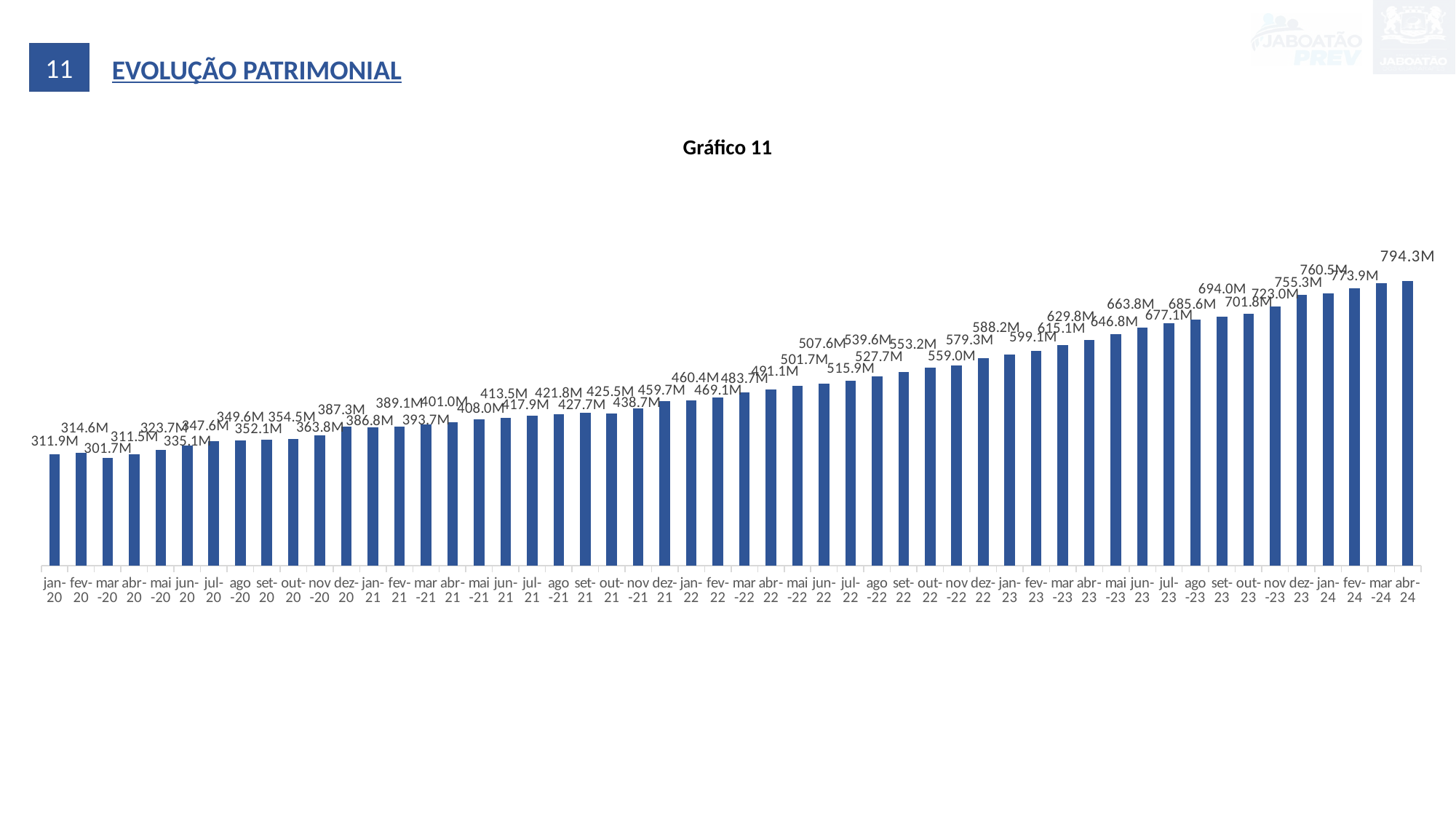
Which month has the highest value? abr-24 What is the value for dez-21? 459.7M How many months (bars) are shown on the chart? 52 What is the value for jun-23? 663.8M Which is larger, the value for dez-23 or the value for dez-22? dez-23 What is the title of the chart on the slide? Gráfico 11 What kind of chart is Gráfico 11? bar chart Do the values generally rise or fall from jan-20 to abr-24? rise What is the value for dez-22? 579.3M What is the difference between the values for abr-24 and jan-20? 482.4M What is the value for jan-20? 311.9M Which month has the lowest value? mar-20